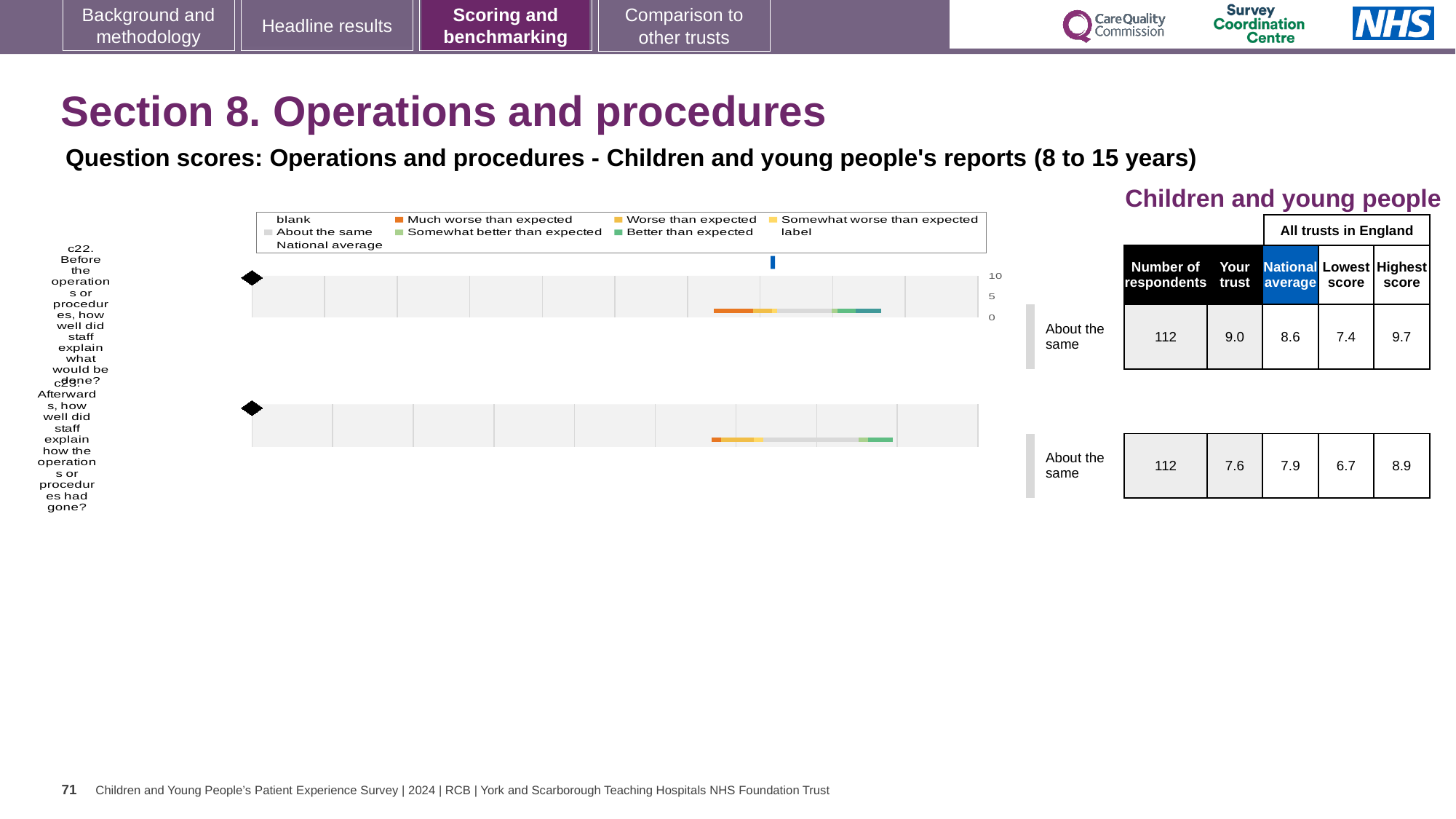
Which question has the higher 'Your trust' score, c22 or c23? c22 What is the highest score across all trusts in England for question c22? 9.7 What is the lowest score across all trusts in England for question c23? 6.7 What benchmark category is the trust placed in for both c22 and c23? About the same How many questions (c22 and c23) are plotted on the slide? 2 What is the 'Your trust' score for question c23 (Afterwards, how well did staff explain how the operations or procedures had gone?)? 7.6 What kind of chart is used to show the benchmark bands for questions c22 and c23? bar chart What is the national average score for question c22? 8.6 How many respondents answered question c22? 112 What is the 'Your trust' score for question c22 (Before the operations or procedures, how well did staff explain what would be done?)? 9.0 What is the difference between the trust's score and the national average for question c22? 0.4 What is the national average score for question c23? 7.9